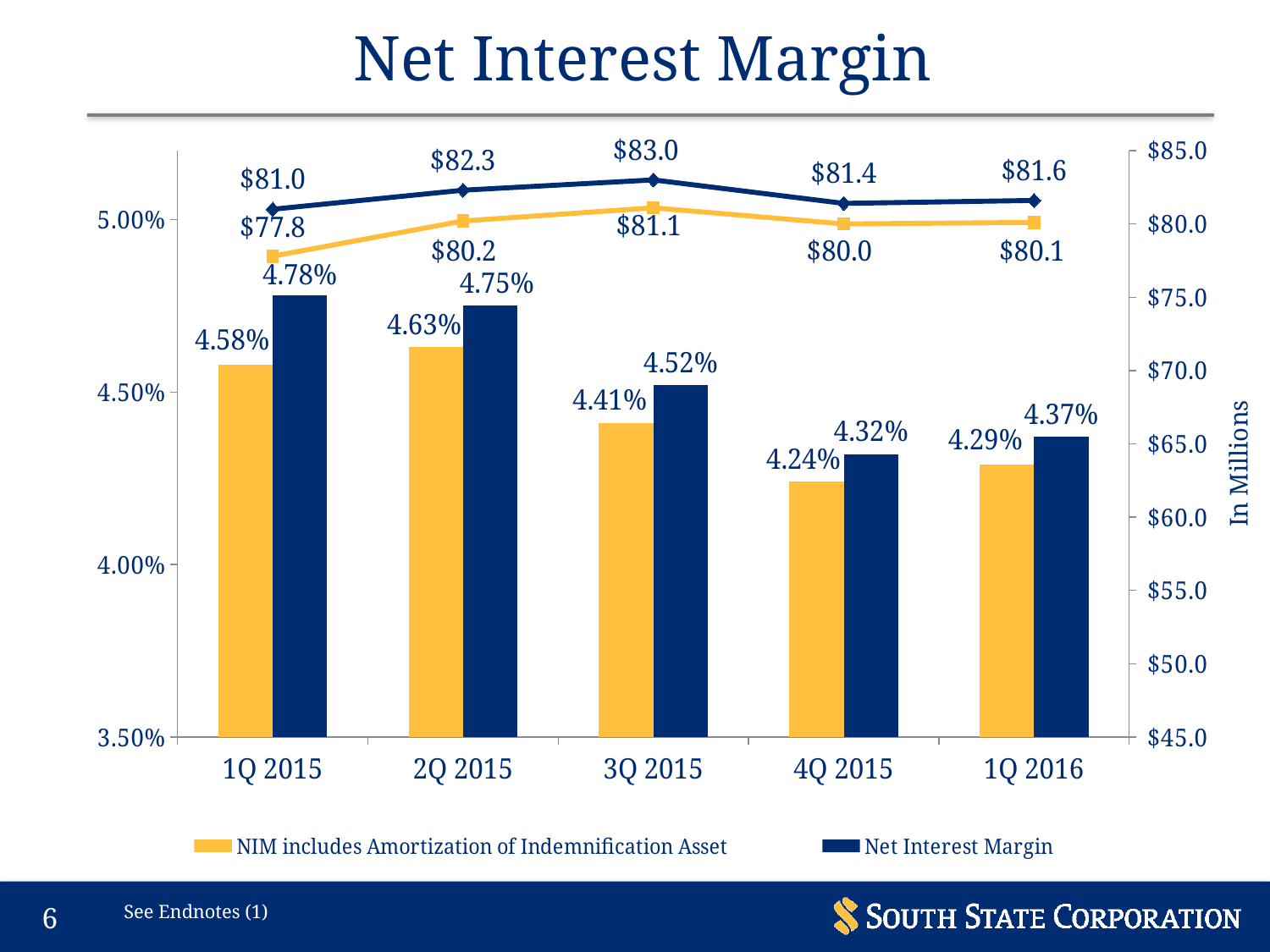
Which is larger in 4Q 2015: the Net Interest Margin or the NIM includes Amortization of Indemnification Asset? Net Interest Margin What is the difference between the Net Interest Margin and the NIM includes Amortization of Indemnification Asset in 2Q 2015? 0.12% Does the Net Interest Margin rise or fall from 1Q 2015 to 4Q 2015? fall How many quarters are shown on the x axis? 5 What is the Net Interest Margin for 3Q 2015? 4.52% In which quarter is the NIM includes Amortization of Indemnification Asset bar lowest? 4Q 2015 What is the title of the chart? Net Interest Margin How many series does the legend list? 2 What is the value labelled on the yellow line for 1Q 2015? $77.8 In which quarter is the Net Interest Margin bar highest? 1Q 2015 What is the highest value labelled on the dark blue line? $83.0 What is the value of NIM includes Amortization of Indemnification Asset for 1Q 2016? 4.29%